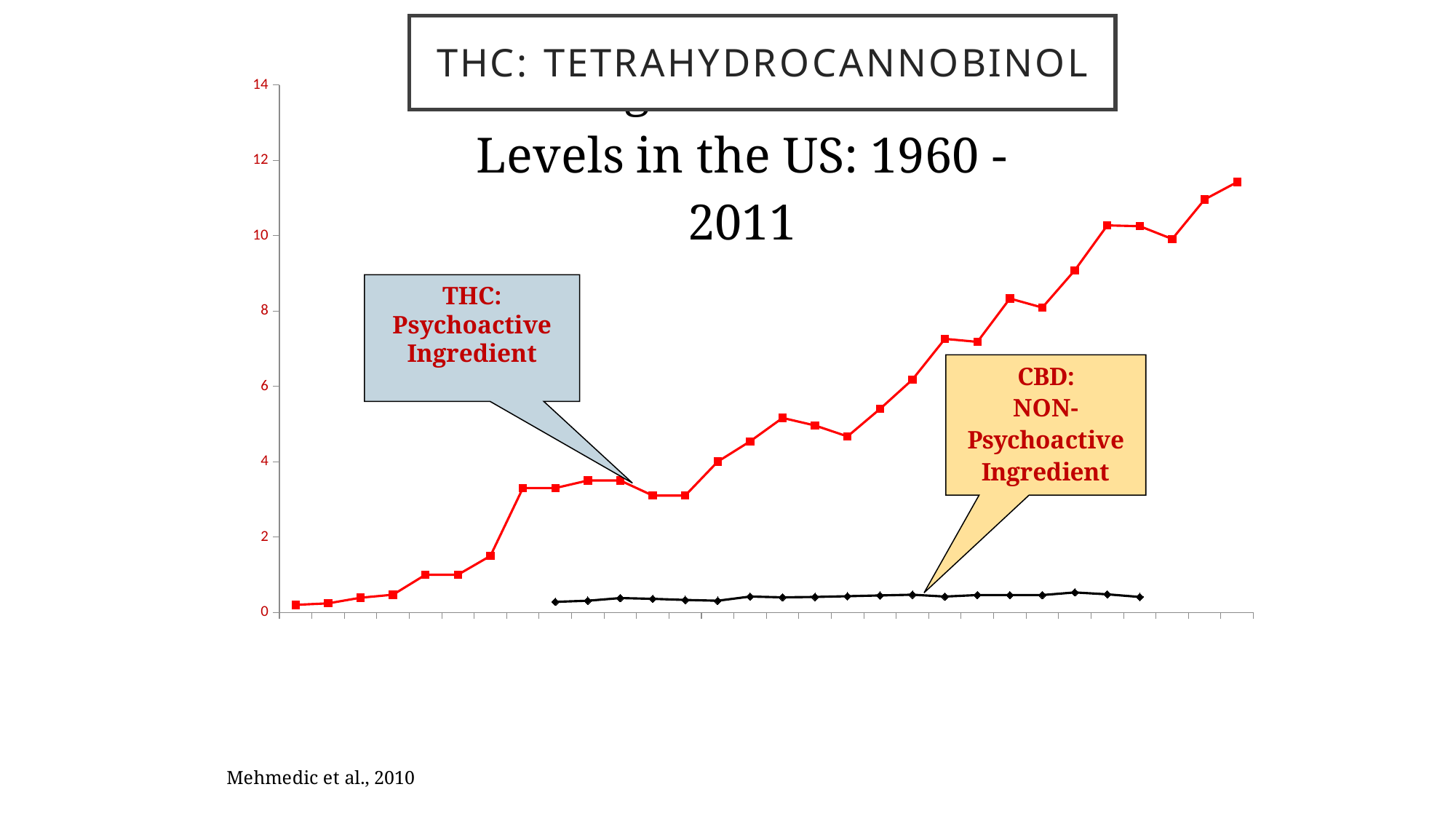
At the right end of the chart, which line is higher, THC or CBD? THC How many data series are plotted on the chart? 2 Is the rightmost value of the THC line greater or less than 10? greater What kind of chart is shown on the slide? line chart Does the THC line generally rise or fall from left to right? rise What is the highest tick value shown on the y axis? 14 Are the values of the CBD line greater or less than 2? less What colour is the THC line on the chart? red Is the peak of the THC line greater or less than 12? less